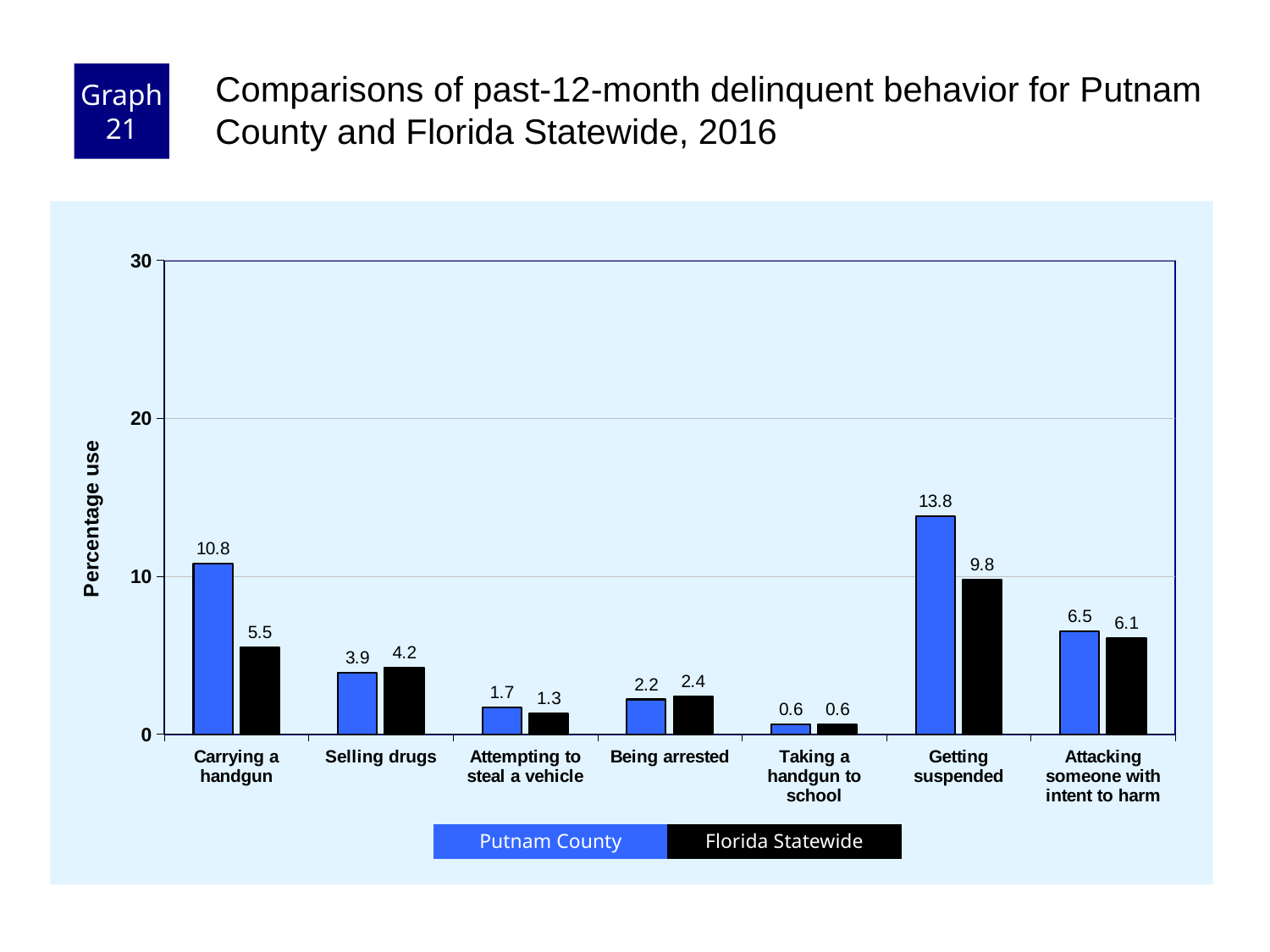
Which is larger for Selling drugs: Putnam County or Florida Statewide? Florida Statewide What is the Putnam County value for Carrying a handgun? 10.8 Is the Putnam County value for Getting suspended greater or less than 10? greater What is the difference between the Putnam County and Florida Statewide values for Carrying a handgun? 5.3 What is the Florida Statewide value for Getting suspended? 9.8 Which category has the highest Putnam County value? Getting suspended What kind of chart is shown on the slide? bar chart What is the label of the y axis? Percentage use What is the Putnam County value for Attempting to steal a vehicle? 1.7 How many series does the legend list? 2 How many categories are shown on the x axis? 7 Which category has the lowest Florida Statewide value? Taking a handgun to school